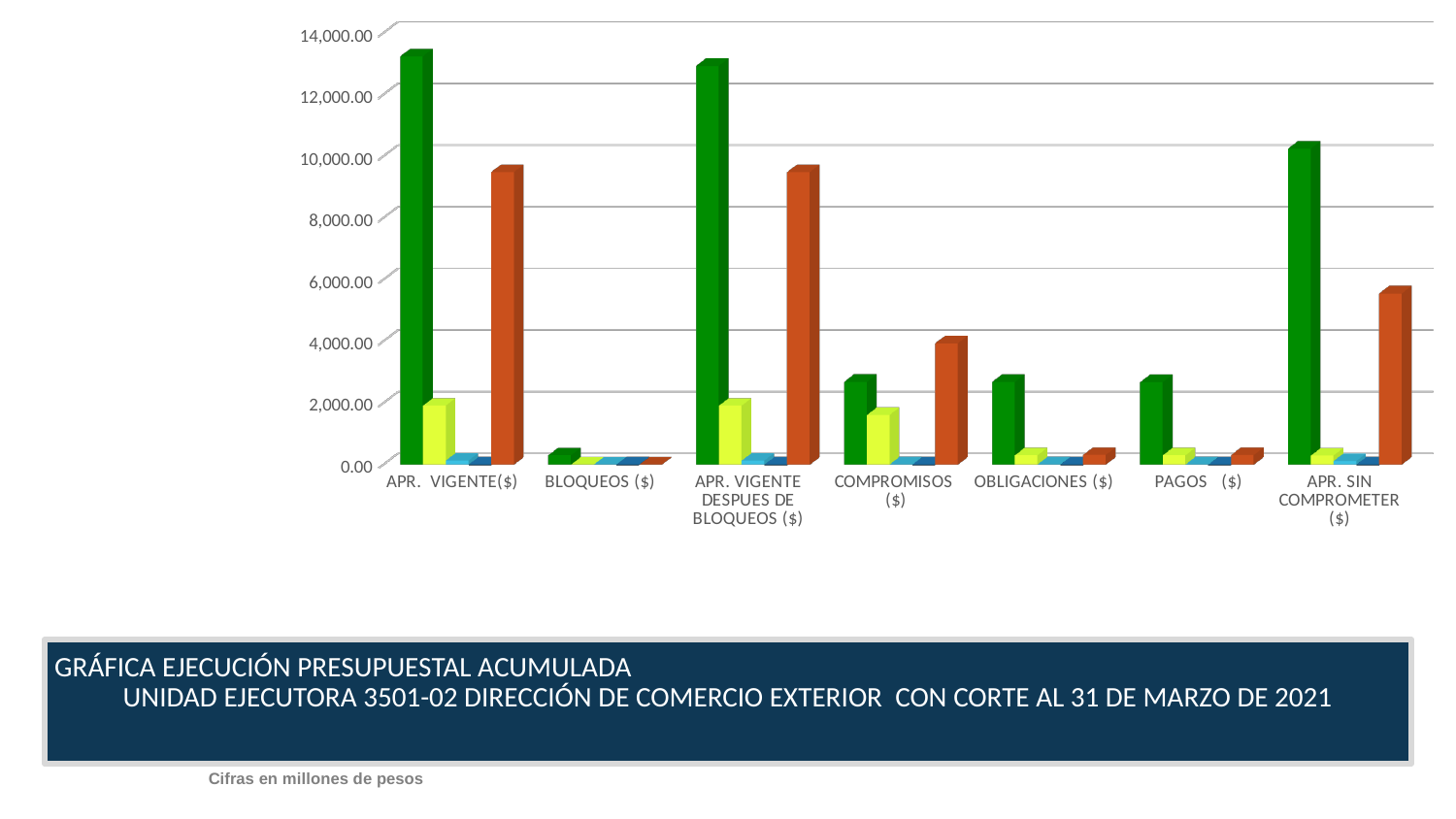
Which is larger: the green bar for APR. VIGENTE($) or the green bar for COMPROMISOS ($)? APR. VIGENTE($) According to the note below the chart, in what units are the figures expressed? Cifras en millones de pesos Is the value of the green bar for COMPROMISOS ($) greater or less than 2,000.00? greater Is the value of the green bar for APR. VIGENTE($) greater or less than 12,000.00? greater How many categories are shown along the x axis of the chart? 7 Is the value of the orange bar for APR. VIGENTE($) greater or less than 10,000.00? less What kind of chart is shown on the slide? bar chart Which category has the lowest green bar? BLOQUEOS ($) For APR. SIN COMPROMETER ($), which is larger: the green bar or the orange bar? the green bar